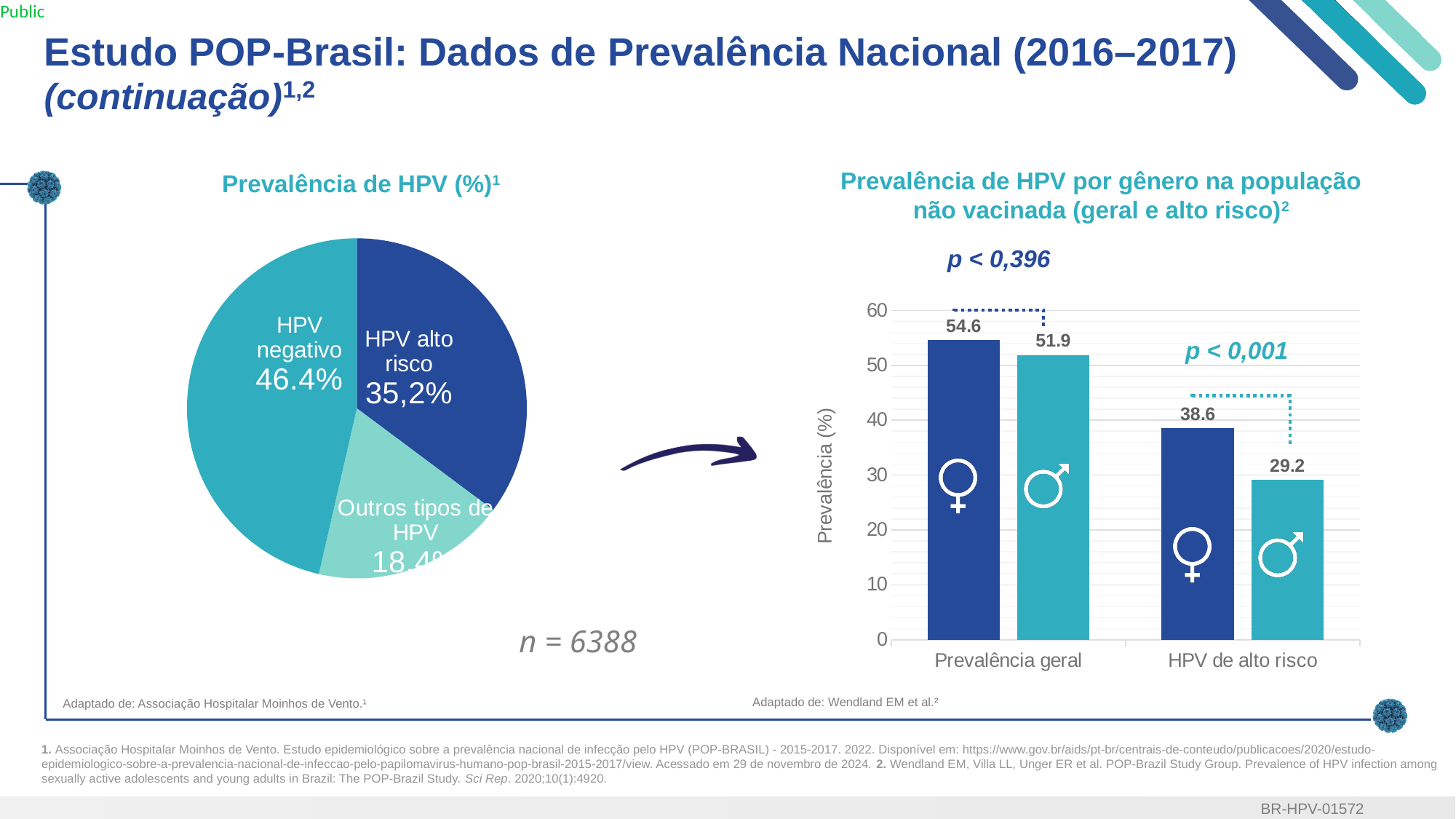
In the pie chart 'Prevalência de HPV (%)', what is the share for HPV negativo? 46.4% In the pie chart 'Prevalência de HPV (%)', which slice is the largest? HPV negativo How many slices does the pie chart 'Prevalência de HPV (%)' have? 3 In the pie chart 'Prevalência de HPV (%)', what is the share for HPV alto risco? 35,2% In the pie chart 'Prevalência de HPV (%)', which slice is the smallest? Outros tipos de HPV In the bar chart on the right, what is the value for females (♀) under Prevalência geral? 54.6 What type of chart is the chart on the right of the slide? Bar chart In the bar chart on the right, what is the difference between the female and male values under HPV de alto risco? 9.4 In the bar chart on the right, what is the label of the y axis? Prevalência (%) In the bar chart on the right, what is the value for males (♂) under HPV de alto risco? 29.2 What type of chart is the chart on the left of the slide? Pie chart In the bar chart on the right, which is larger under Prevalência geral: the female value or the male value? Female (54.6)